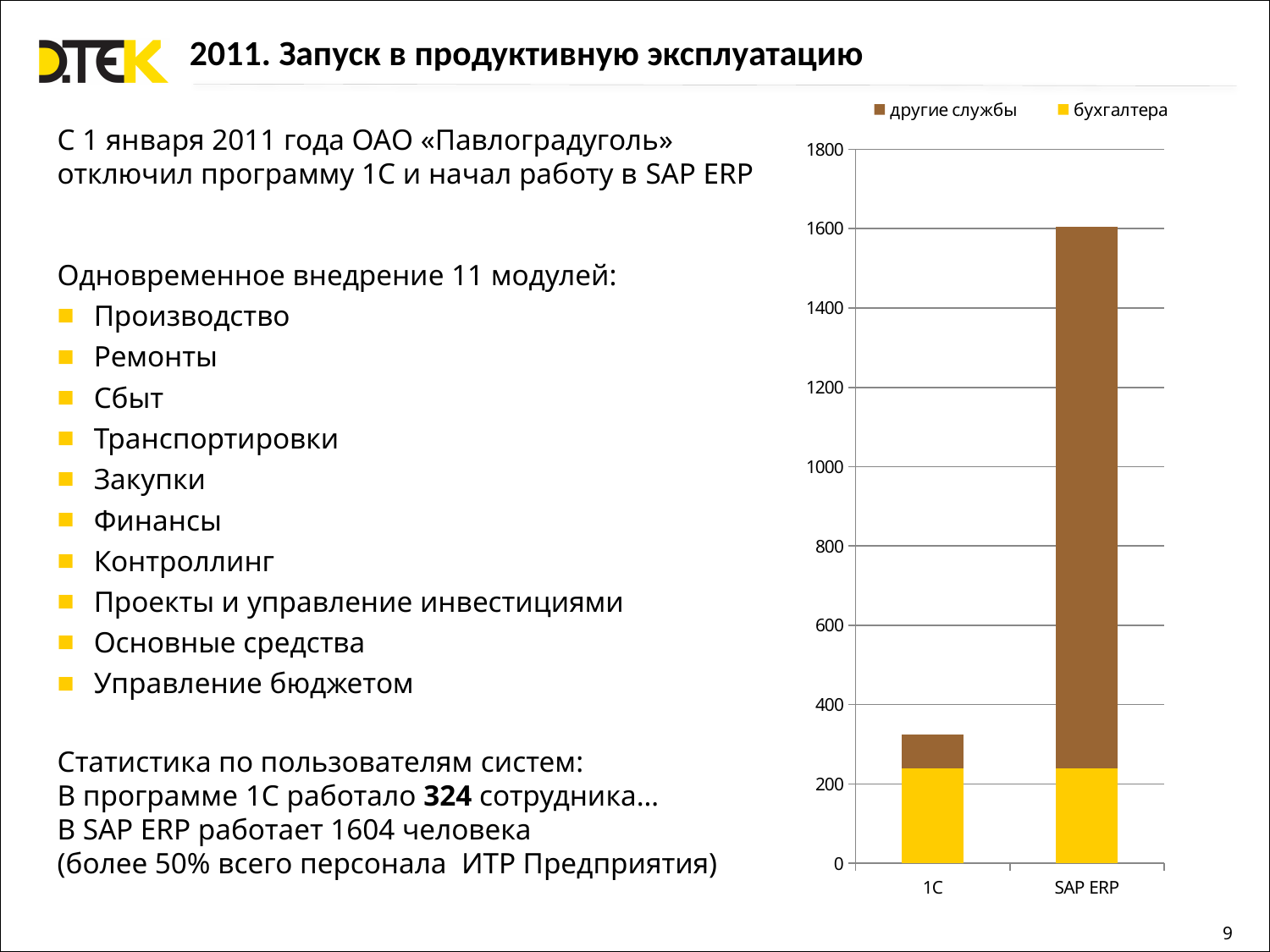
Which colour represents the 'бухгалтера' series in the chart? Yellow What are the two series named in the chart legend? другие службы, бухгалтера How many categories are shown on the x axis of the chart? 2 Which category has the shorter stacked bar? 1C Which category has the taller stacked bar, 1C or SAP ERP? SAP ERP Is the total bar for SAP ERP larger or smaller than the total bar for 1C? Larger Is the total value of the 1C bar greater or less than 200? greater Is the 'бухгалтера' segment of the SAP ERP bar greater or less than 400? less What kind of chart is shown on the slide? Stacked bar chart Is the total value of the 1C bar greater or less than 400? less How many series does the chart legend list? 2